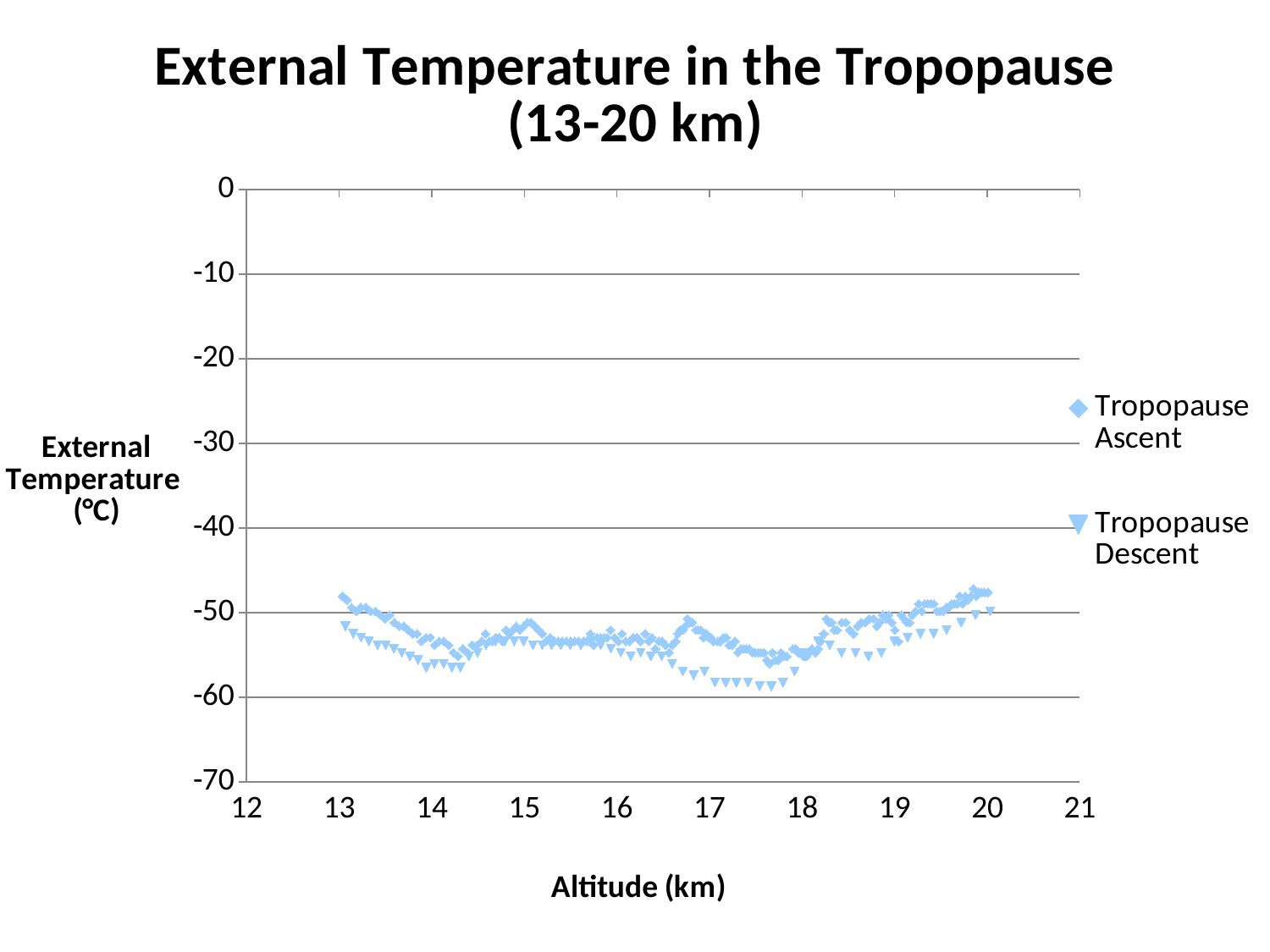
Between about 17.5 km and 20 km altitude, do the Tropopause Ascent temperatures rise or fall? rise Are all plotted temperature values greater or less than -40? less How many series does the legend list? 2 What is the label of the x axis? Altitude (km) Between about 13 km and 14 km altitude, do the Tropopause Descent temperatures rise or fall? fall What kind of chart is shown on the slide? Scatter chart Is the Tropopause Descent value at about 17.5 km greater or less than -50? less Is the Tropopause Descent value at about 14 km greater or less than -60? greater At about 17.5 km altitude, which series has the higher temperature, Tropopause Ascent or Tropopause Descent? Tropopause Ascent Which series reaches the lowest temperature on the chart, Tropopause Ascent or Tropopause Descent? Tropopause Descent What is the title of the chart? External Temperature in the Tropopause (13-20 km)